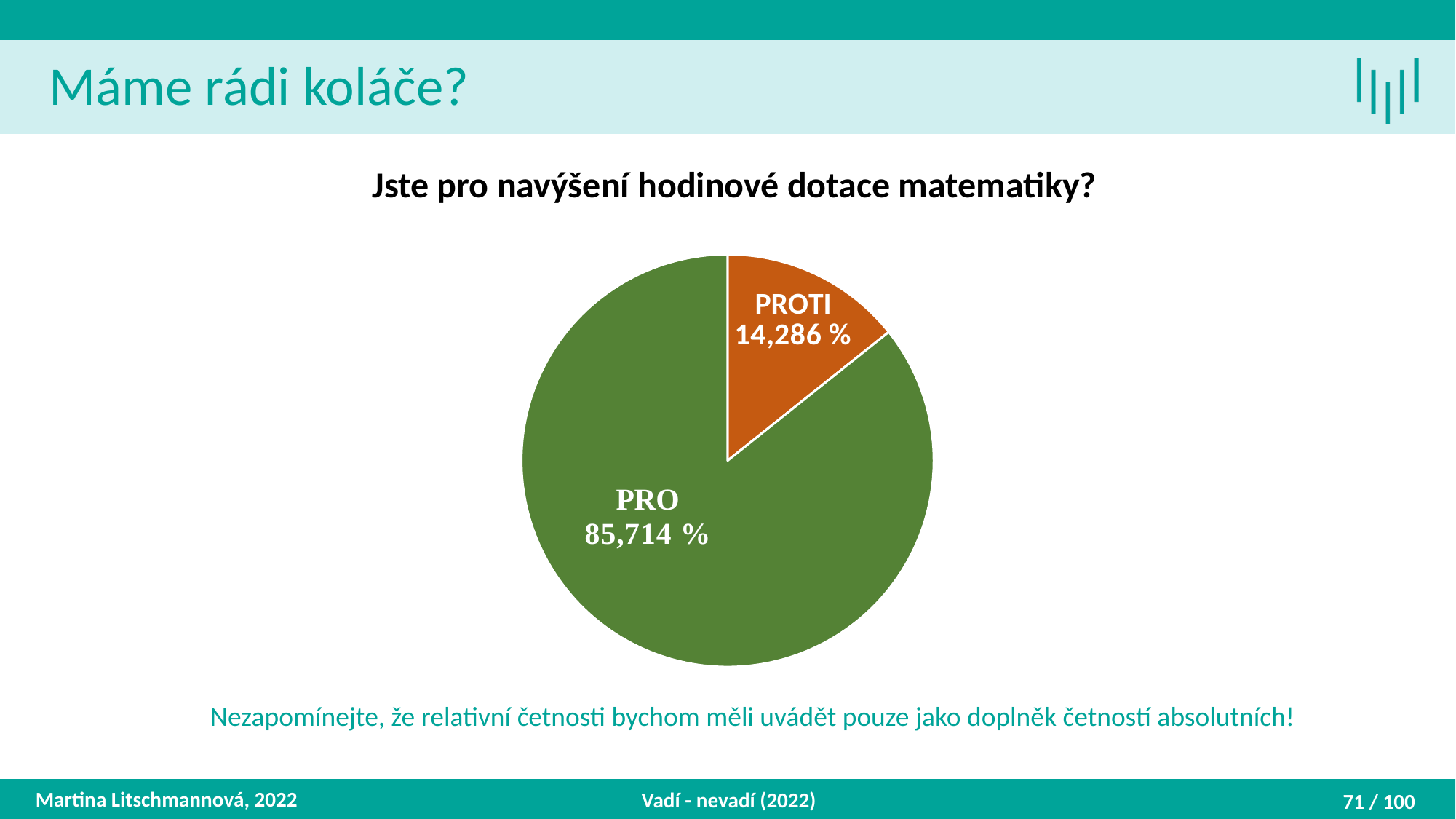
Which slice of the pie is the largest? PRO What is the chart's title? Jste pro navýšení hodinové dotace matematiky? What colour is the PROTI slice? orange What kind of chart is shown on the slide? pie chart What is the difference in percentage points between the PRO and PROTI slices? 71,428 % What share of the pie does the PROTI slice represent? 14,286 % How many slices does the pie chart have? 2 What share of the pie does the PRO slice represent? 85,714 % Which slice of the pie is the smallest? PROTI Which is larger, the PRO slice or the PROTI slice? PRO